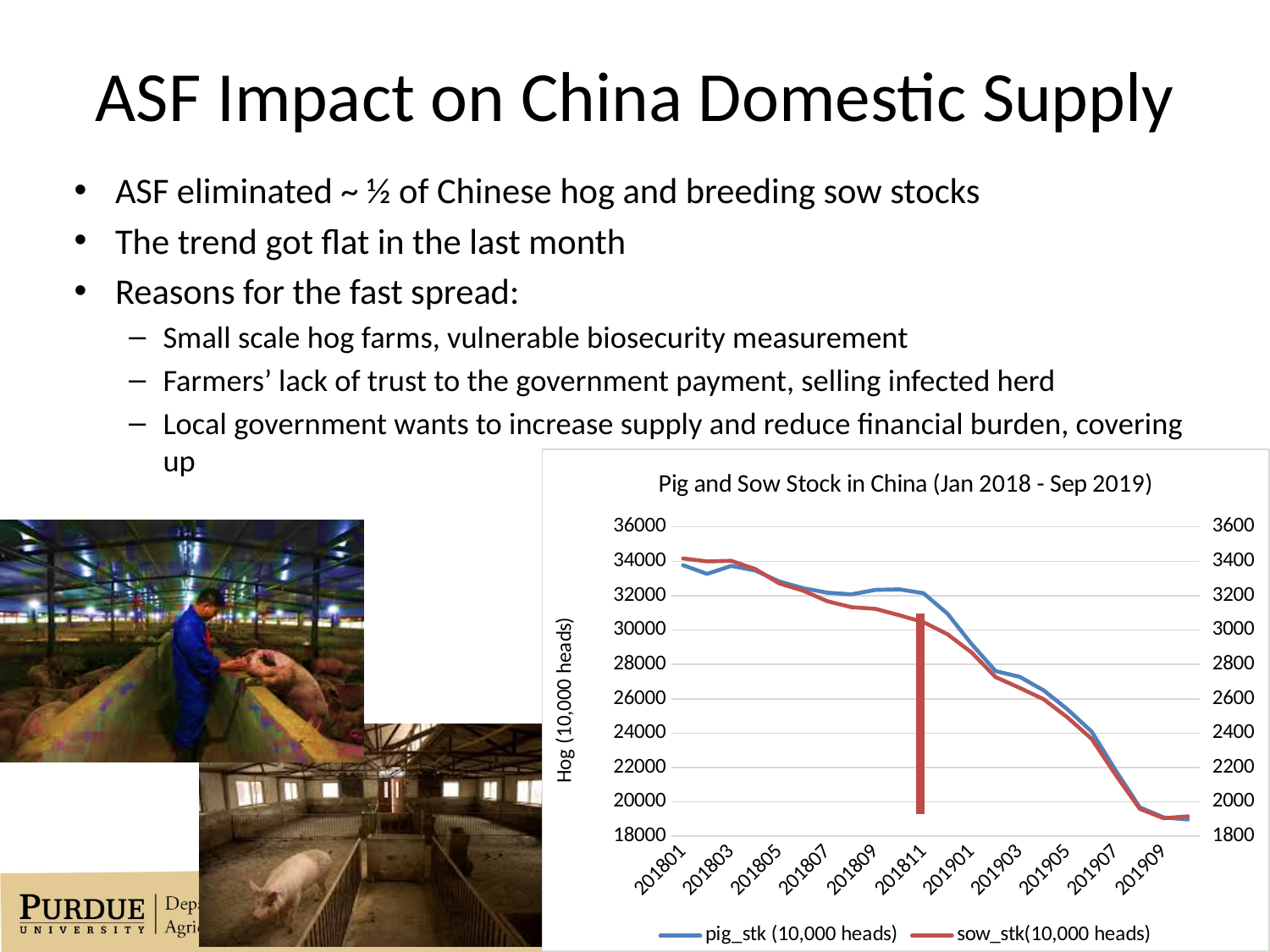
Is the pig_stk value at 201801 greater or less than 32000? greater What are the two series named in the chart legend? pig_stk (10,000 heads) and sow_stk(10,000 heads) Is the pig_stk value at 201903 greater or less than 30000? less How many month labels are shown along the x axis of the chart? 11 What kind of chart is shown on the slide? line chart How many series does the chart legend list? 2 Which is larger, the pig_stk value at 201801 or at 201909? 201801 Is the sow_stk value at 201801 greater or less than 3200 on the right axis? greater Do the pig_stk values rise or fall from 201801 to 201909? fall What is the title of the chart? Pig and Sow Stock in China (Jan 2018 - Sep 2019)